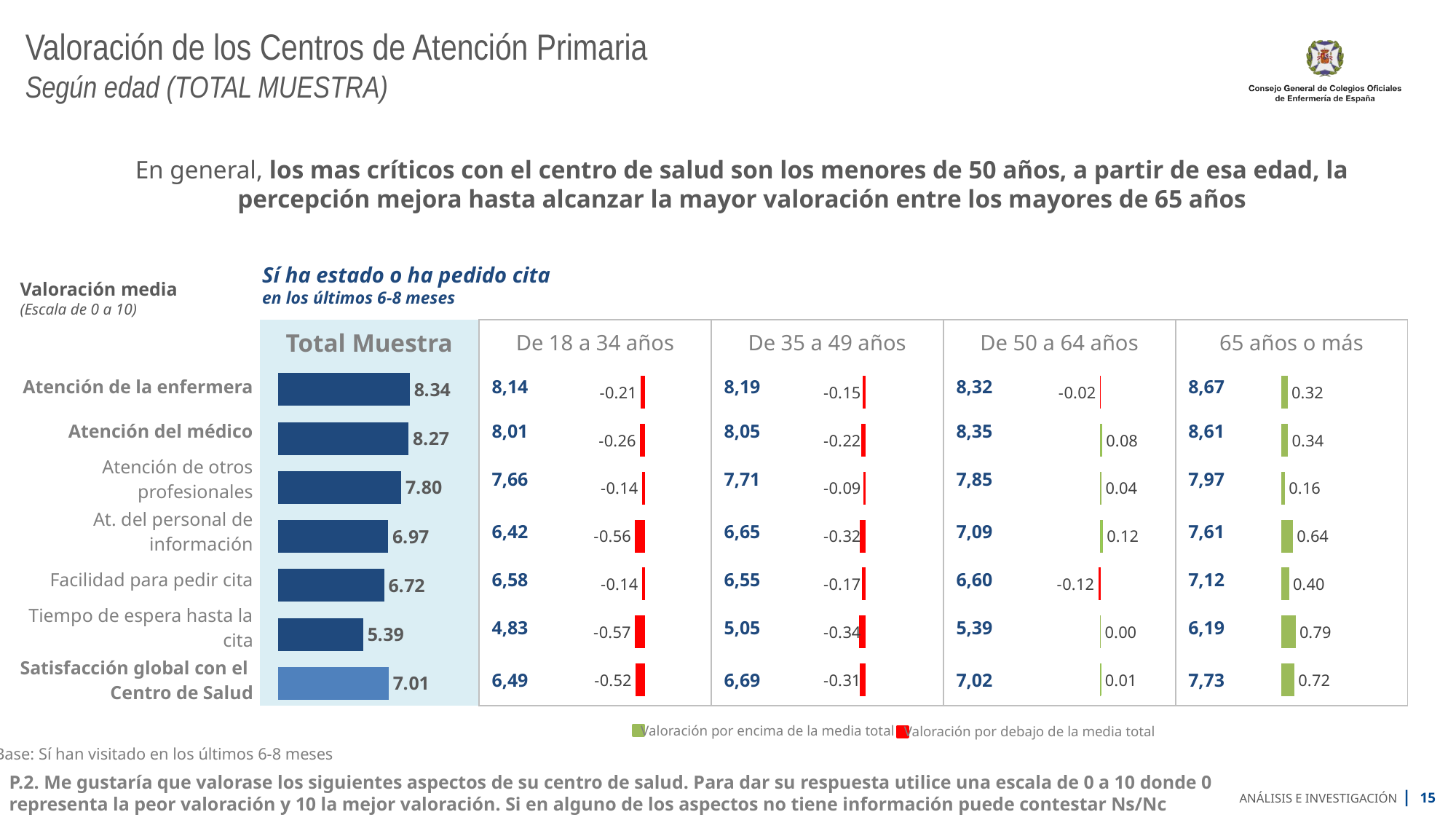
In the 65 años o más column, what is the value for Tiempo de espera hasta la cita? 6,19 In the Total Muestra bar chart, which is larger: At. del personal de información or Facilidad para pedir cita? At. del personal de información In the De 50 a 64 años column, what is the deviation from the total mean shown for Tiempo de espera hasta la cita? 0.00 In the De 18 a 34 años column, what is the deviation from the total mean shown for At. del personal de información? -0.56 In the Total Muestra bar chart, which category has the highest value? Atención de la enfermera How many categories are shown in the Total Muestra bar chart? 7 In the Total Muestra bar chart, what is the value for Atención de la enfermera? 8.34 In the Total Muestra bar chart, which category has the lowest value? Tiempo de espera hasta la cita According to the legend, what does a red bar indicate? Valoración por debajo de la media total In the Total Muestra bar chart, what is the value for Tiempo de espera hasta la cita? 5.39 What kind of chart is used for the Total Muestra column? Bar chart In the Total Muestra bar chart, what is the difference between Atención del médico and Satisfacción global con el Centro de Salud? 1.26